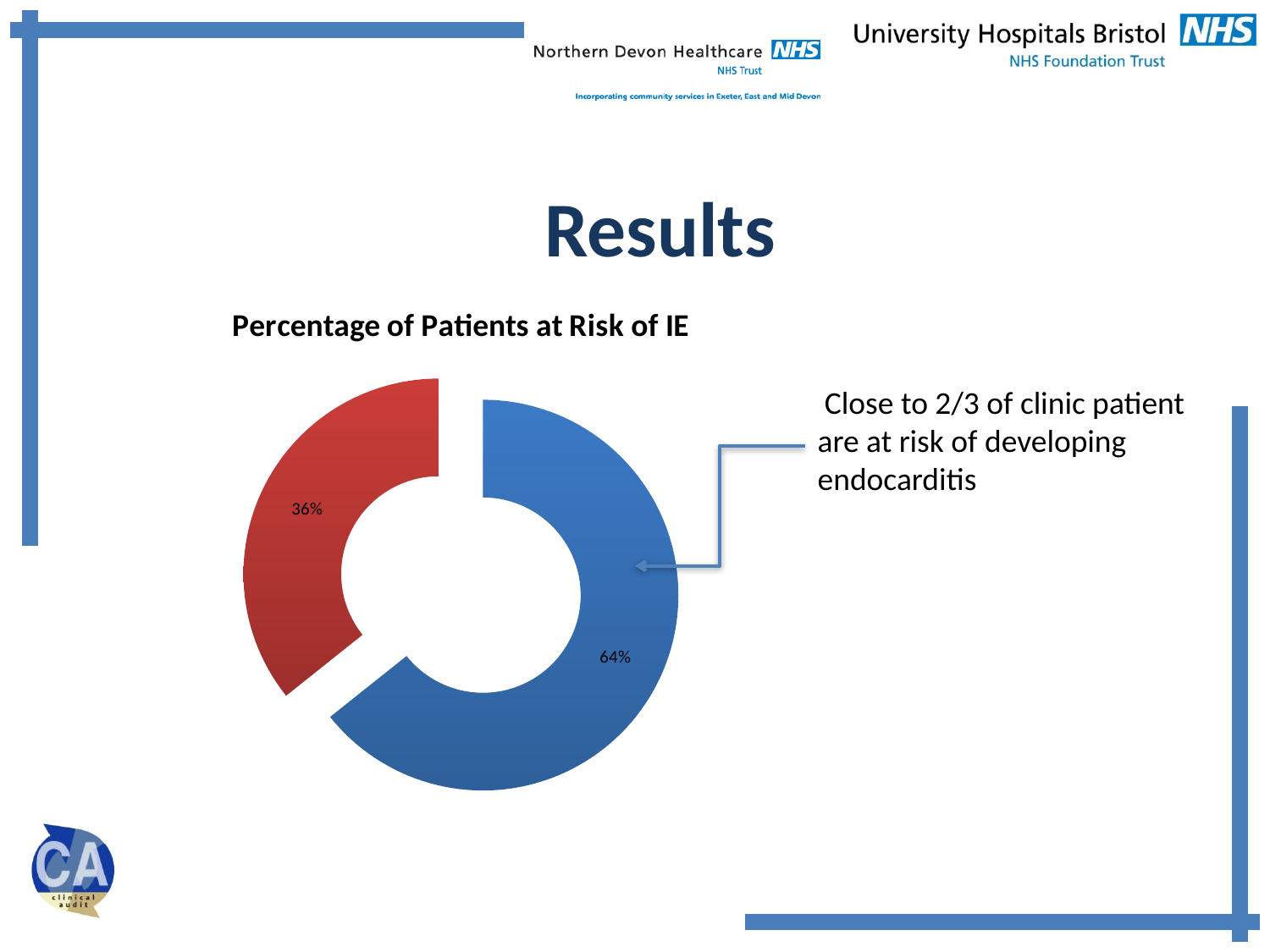
What share of the chart does the blue slice represent? 64% What percentage is shown on the blue slice of the chart? 64% Which slice of the chart is the smallest? the red slice (36%) Is the blue slice or the red slice larger? the blue slice What percentage is shown on the red slice of the chart? 36% What is the difference in percentage points between the blue slice and the red slice? 28 What kind of chart is shown on the slide? doughnut chart What is the title of the chart? Percentage of Patients at Risk of IE How many slices does the chart have? 2 Which slice of the chart is the largest? the blue slice (64%) According to the annotation on the slide, what does the 64% slice represent? clinic patients at risk of developing endocarditis What do the two slices of the chart add up to? 100%